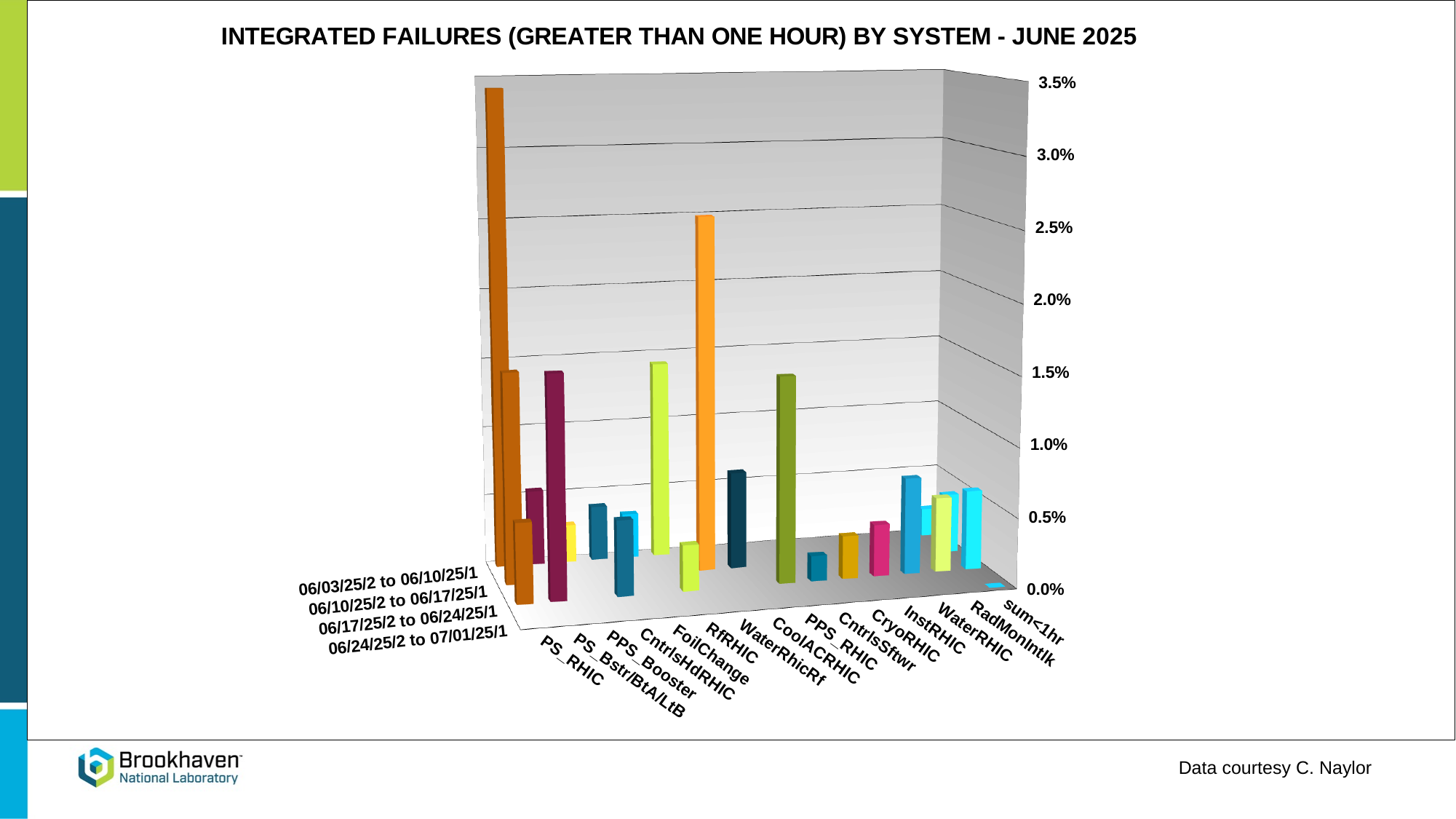
What is the maximum value shown on the vertical axis of the chart? 3.5% How many system categories are shown along the horizontal axis of the chart? 15 Is the tallest bar for CryoRHIC greater or less than 1.0%? less Is the tallest bar for FoilChange greater or less than 1.0%? less What is the title of the chart? INTEGRATED FAILURES (GREATER THAN ONE HOUR) BY SYSTEM - JUNE 2025 Is the tallest bar for PS_RHIC greater or less than 3.0%? greater Which system has the tallest bar in the chart? PS_RHIC How many weekly date ranges are plotted in the chart? 4 Which has a taller bar: PS_RHIC or WaterRHIC? PS_RHIC What kind of chart is shown on the slide? bar chart